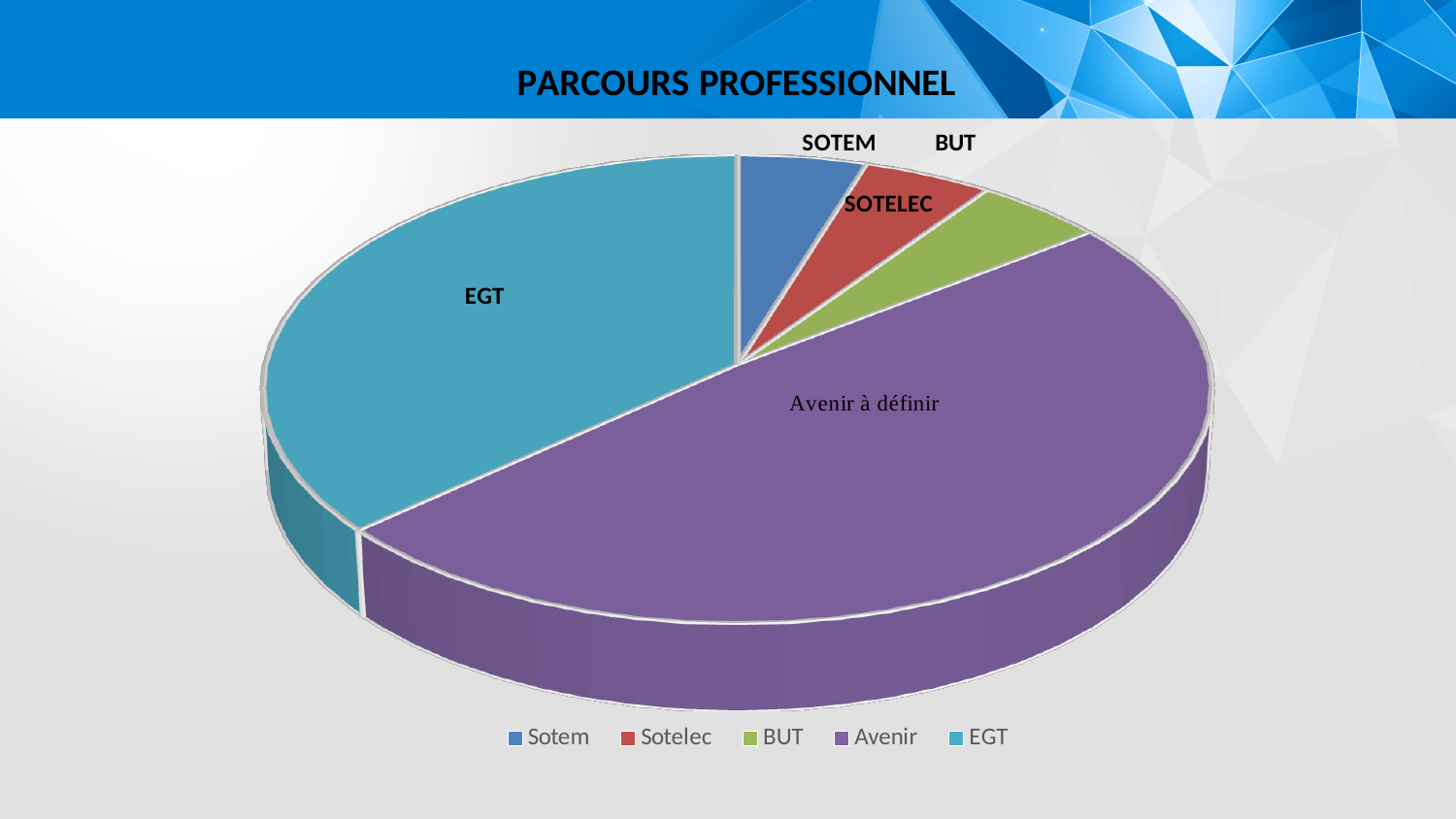
Which slice is larger, Avenir or BUT? Avenir Which category has the largest slice of the pie? Avenir Which slice is larger, Avenir or EGT? Avenir What is the title of the chart? PARCOURS PROFESSIONNEL What kind of chart is shown on the slide? Pie chart Which category is the second largest slice of the pie? EGT How many entries does the legend list? 5 How many slices does the pie chart have? 5 What colour is the Avenir slice? Purple Which slice is larger, EGT or Sotem? EGT